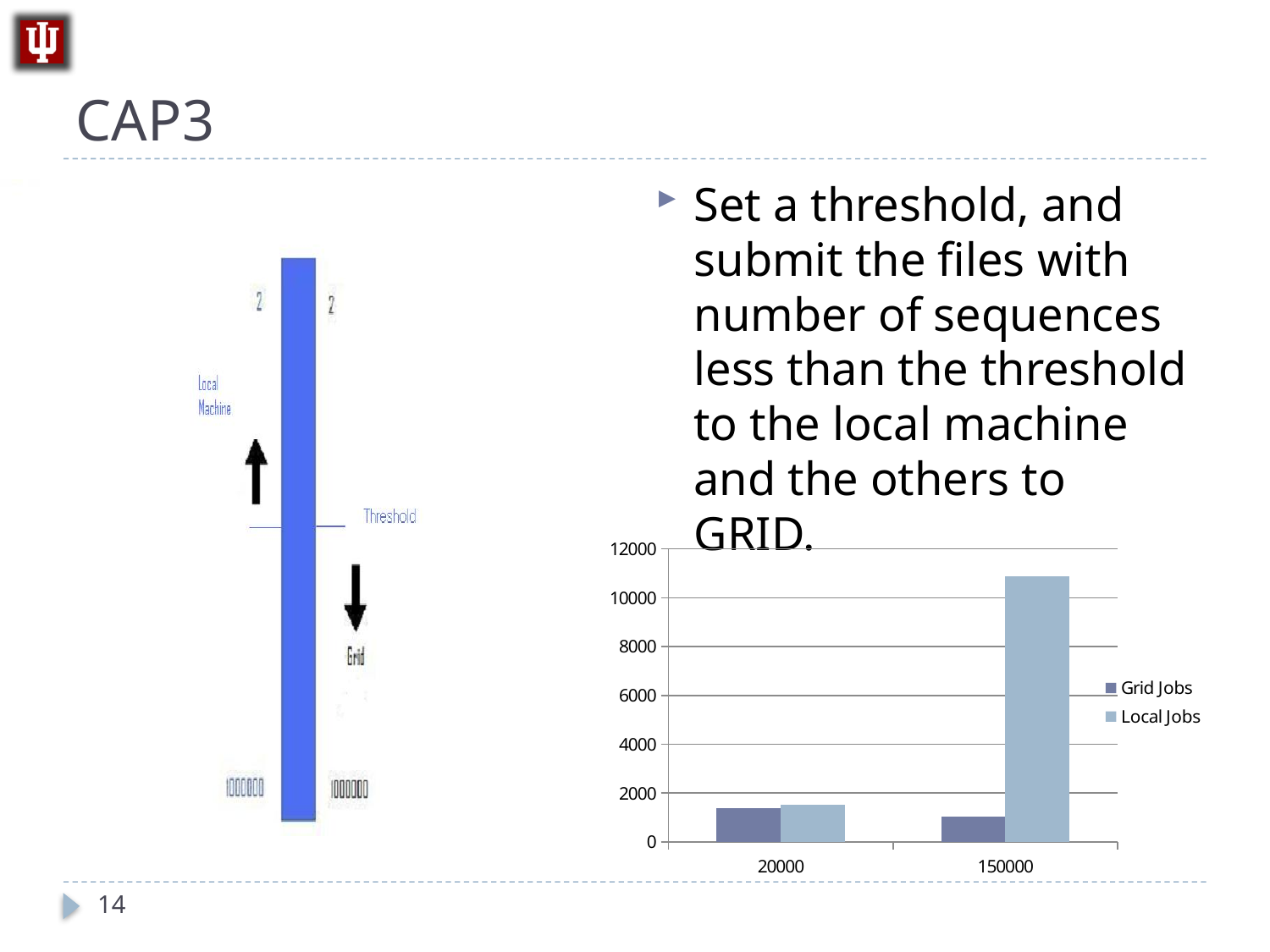
At 150000, which is larger: Grid Jobs or Local Jobs? Local Jobs How many categories are shown on the x axis of the bar chart? 2 Do the Local Jobs values rise or fall from 20000 to 150000? rise Is the value for Grid Jobs at 20000 greater or less than 2000? less How many series does the legend of the bar chart list? 2 What kind of chart is shown on the slide? bar chart For the Local Jobs series, which category has the highest value? 150000 What are the two series listed in the legend of the bar chart? Grid Jobs and Local Jobs Is the value for Local Jobs at 20000 greater or less than 4000? less Is the value for Grid Jobs at 150000 greater or less than 2000? less Which series in the bar chart is drawn in the lighter blue colour? Local Jobs